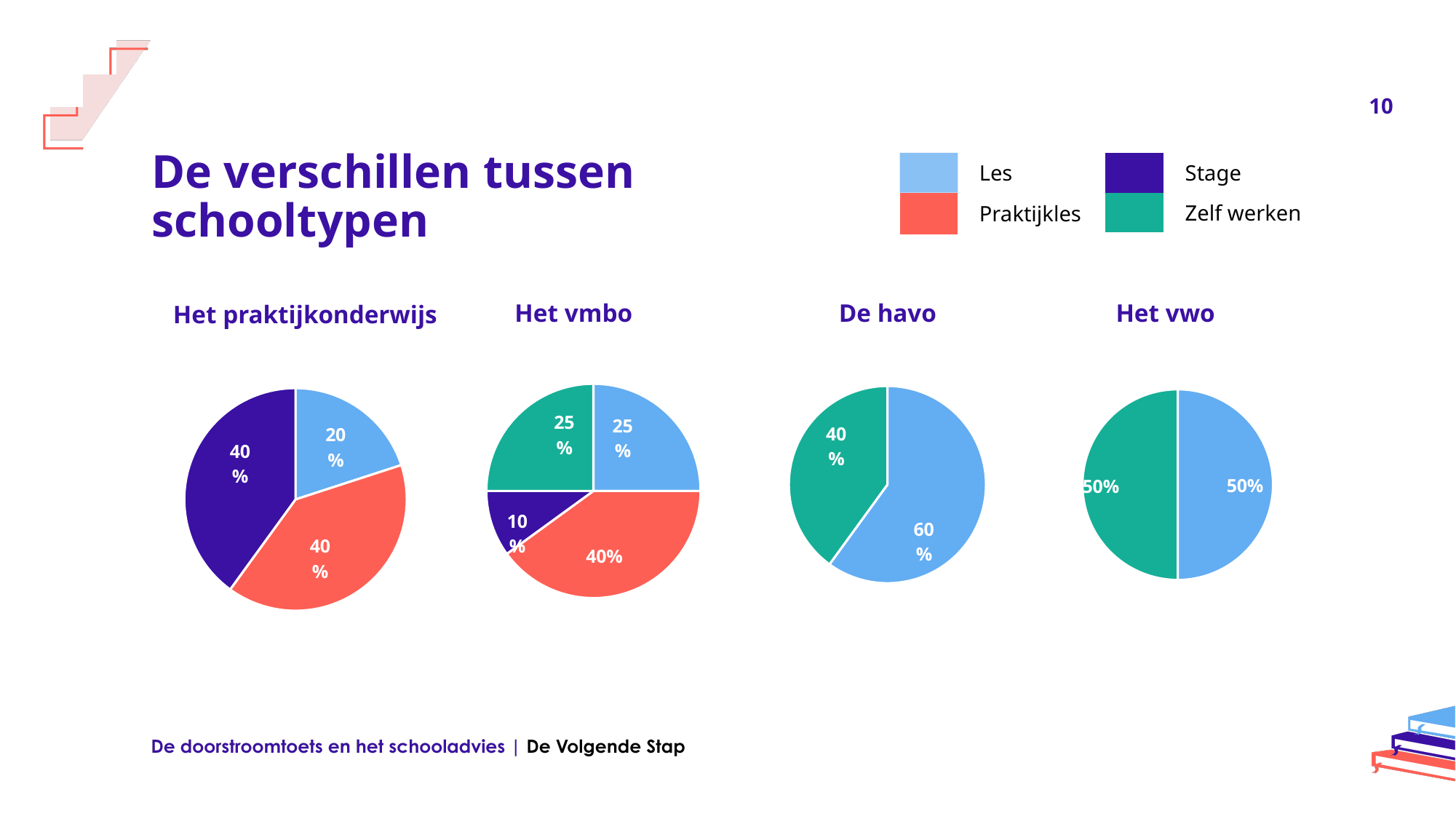
What type of chart is used for 'De havo'? Pie chart How many slices does the 'Het vmbo' pie chart have? 4 In the 'De havo' pie chart, what share is Les? 60% In the 'Het praktijkonderwijs' pie chart, which category has the smallest share? Les In the 'Het vmbo' pie chart, which category has the smallest share? Stage In the 'De havo' pie chart, what is the difference between the Les share and the Zelf werken share? 20% In the 'Het vwo' pie chart, what share is Zelf werken? 50% In the 'Het vmbo' pie chart, which category has the largest share? Praktijkles In the 'Het vmbo' pie chart, which is larger: the Les share or the Stage share? Les How many entries does the legend list? 4 In the 'Het vmbo' pie chart, what share is Stage? 10% In the 'Het praktijkonderwijs' pie chart, what share is Les? 20%